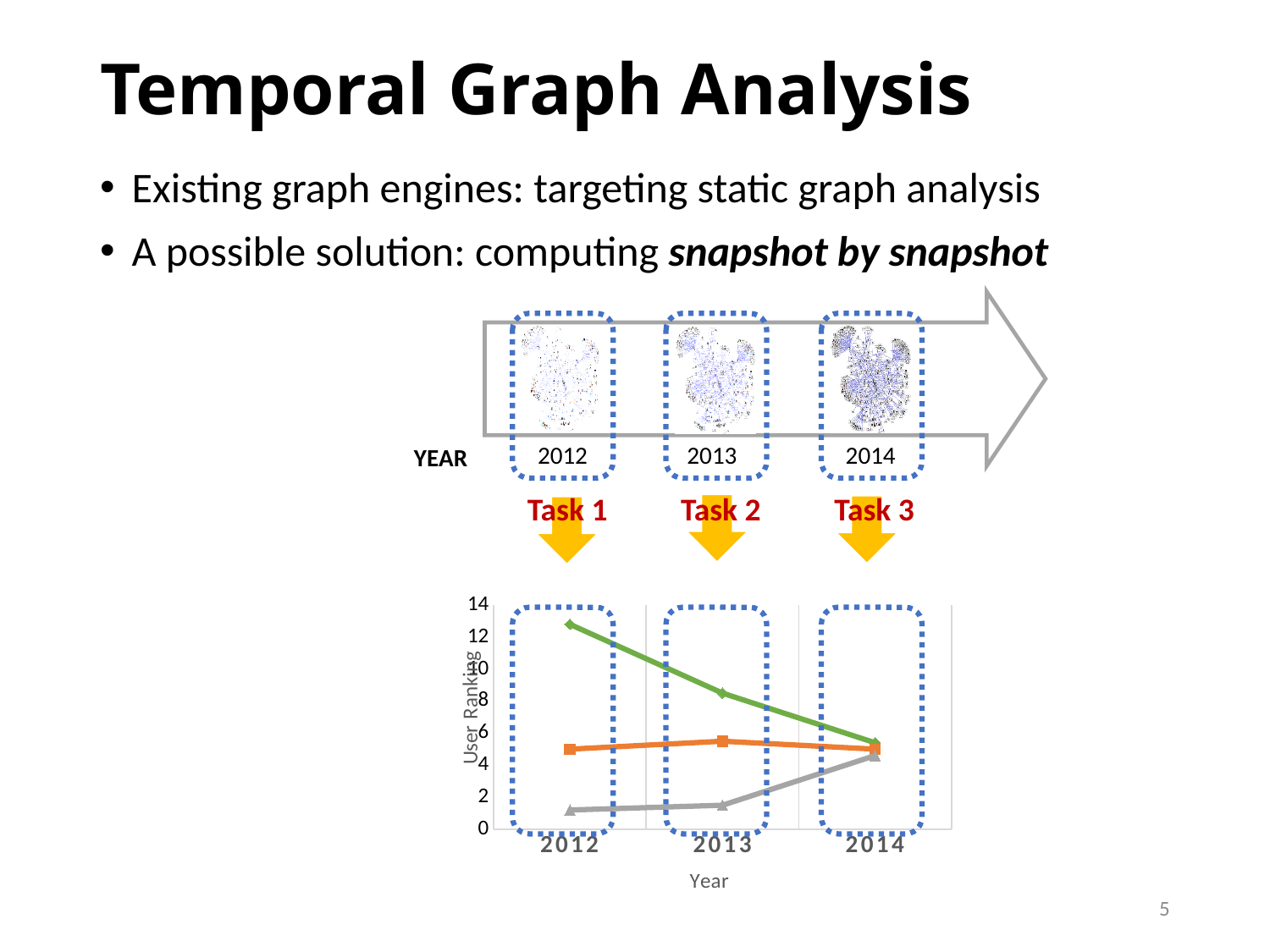
Is the value of the green line in 2012 greater or less than 10? greater Does the gray line rise or fall from 2012 to 2014? rise Does the green line rise or fall from 2012 to 2014? fall In which year does the gray line reach its highest value? 2014 Is the value of the green line in 2013 greater or less than 6? greater In 2012, which line has the higher value, the green line or the gray line? green line Is the value of the gray line in 2012 greater or less than 2? less How many years are plotted along the x axis of the chart? 3 In 2013, which line has the higher value, the orange line or the gray line? orange line What is the title of the chart's y axis? User Ranking What kind of chart is shown at the bottom of the slide? line chart In which year does the green line reach its highest value? 2012